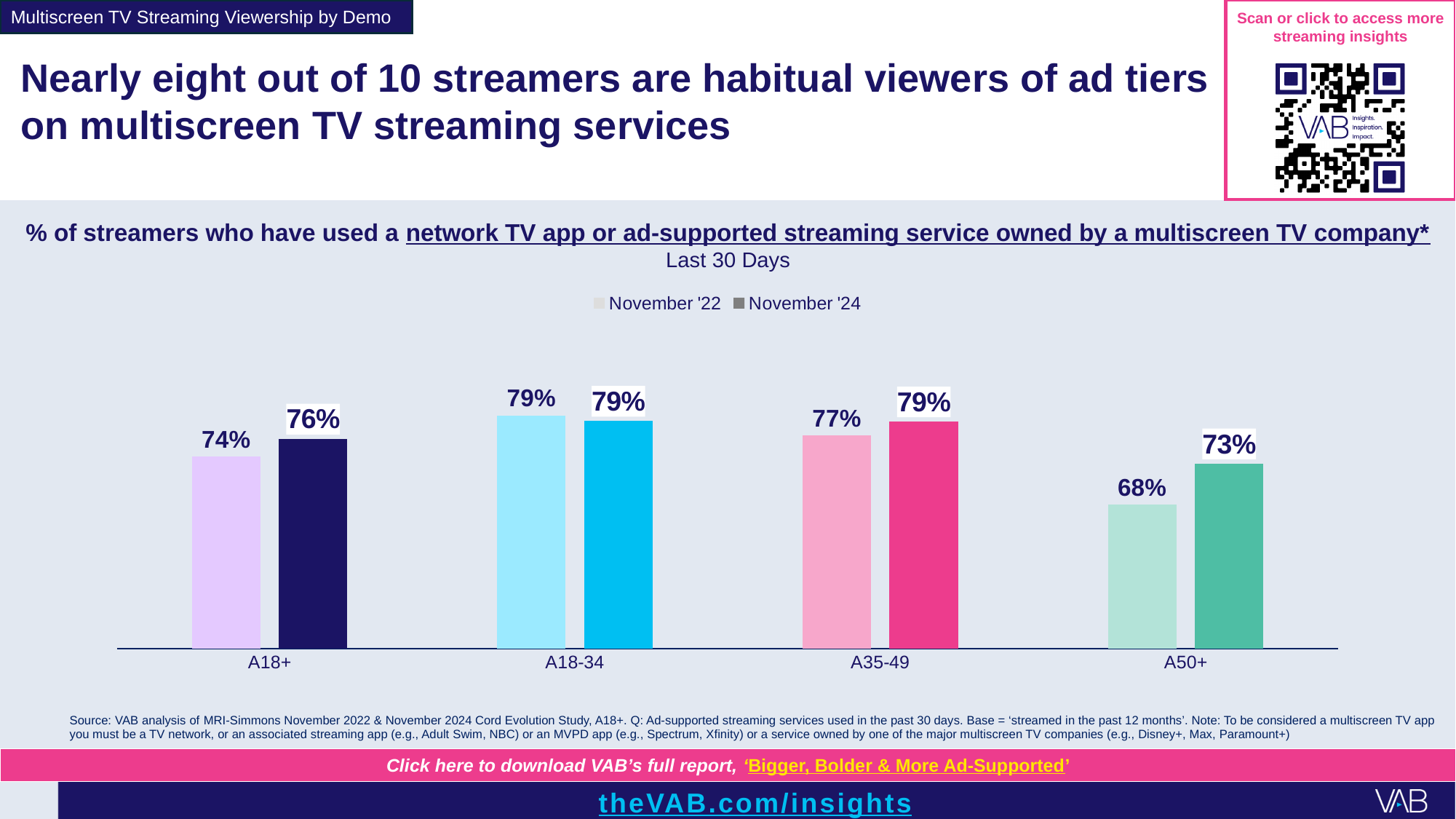
Which demo has the lowest November '24 value? A50+ What are the two series named in the legend? November '22 and November '24 Which is larger for A35-49: the November '22 value or the November '24 value? November '24 What is the difference between the November '24 and November '22 values for A18+? 2% What is the November '22 value for A35-49? 77% What is the November '22 value for A50+? 68% What is the difference between the November '24 and November '22 values for A50+? 5% How many demo categories are shown on the x axis? 4 What is the November '24 value for A18+? 76% What kind of chart is shown on the slide? Bar chart How many series does the legend list? 2 Which demo has the lowest November '22 value? A50+